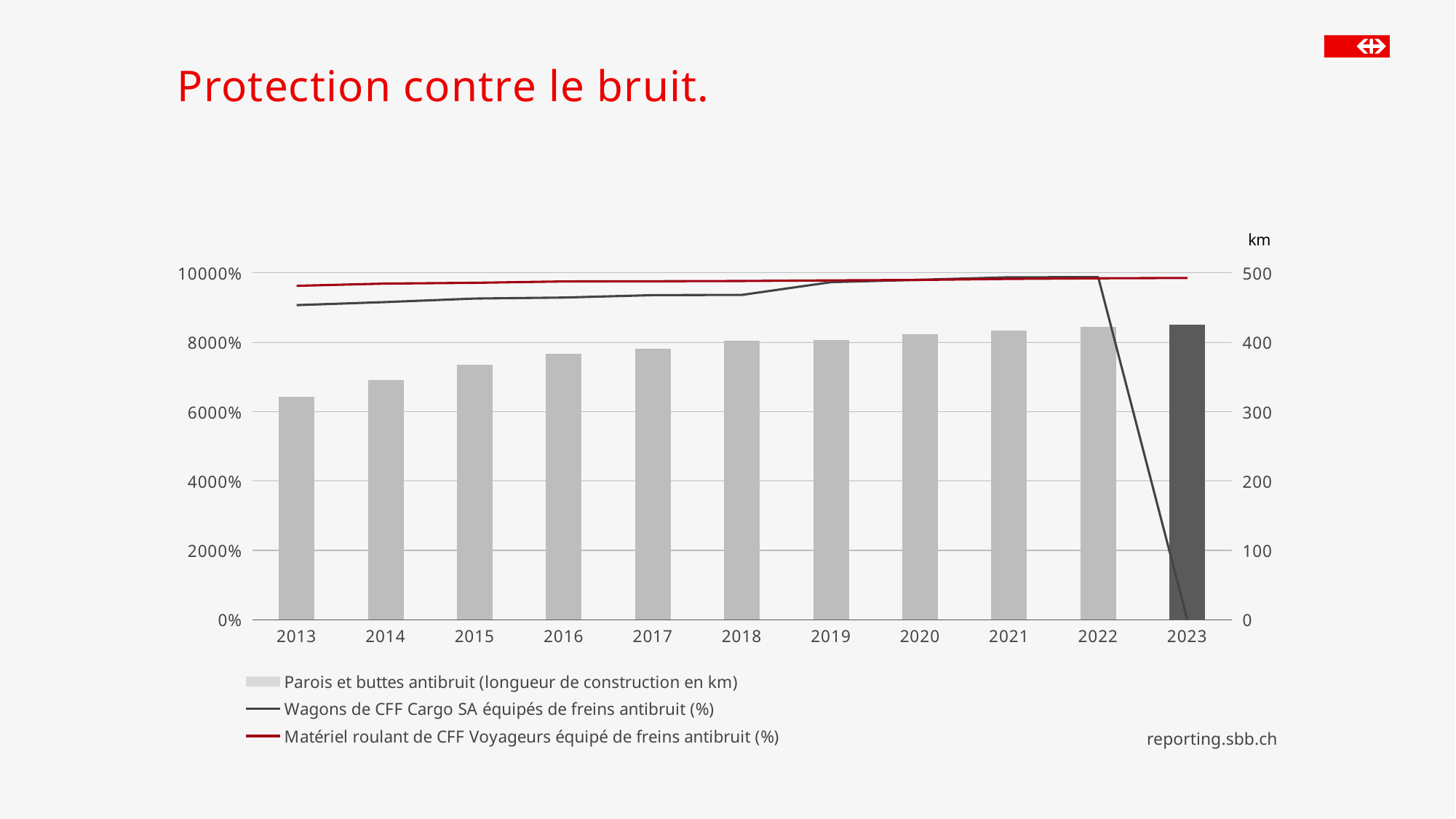
Which year has the shortest bar for Parois et buttes antibruit? 2013 How many years are shown on the x axis? 11 Do the bars for Parois et buttes antibruit rise or fall from 2013 to 2023? Rise What is the title of the chart on the slide? Protection contre le bruit. How many series does the legend list? 3 Is the bar for Parois et buttes antibruit in 2013 greater or less than 300 km? greater Which year has the tallest bar for Parois et buttes antibruit? 2023 Which is larger, the bar for Parois et buttes antibruit in 2013 or in 2023? 2023 What unit is shown at the top of the right-hand axis? km Is the bar for Parois et buttes antibruit in 2016 greater or less than 400 km? less Is the bar for Parois et buttes antibruit in 2023 greater or less than 400 km? greater What kind of chart is shown on the slide? Combined bar and line chart